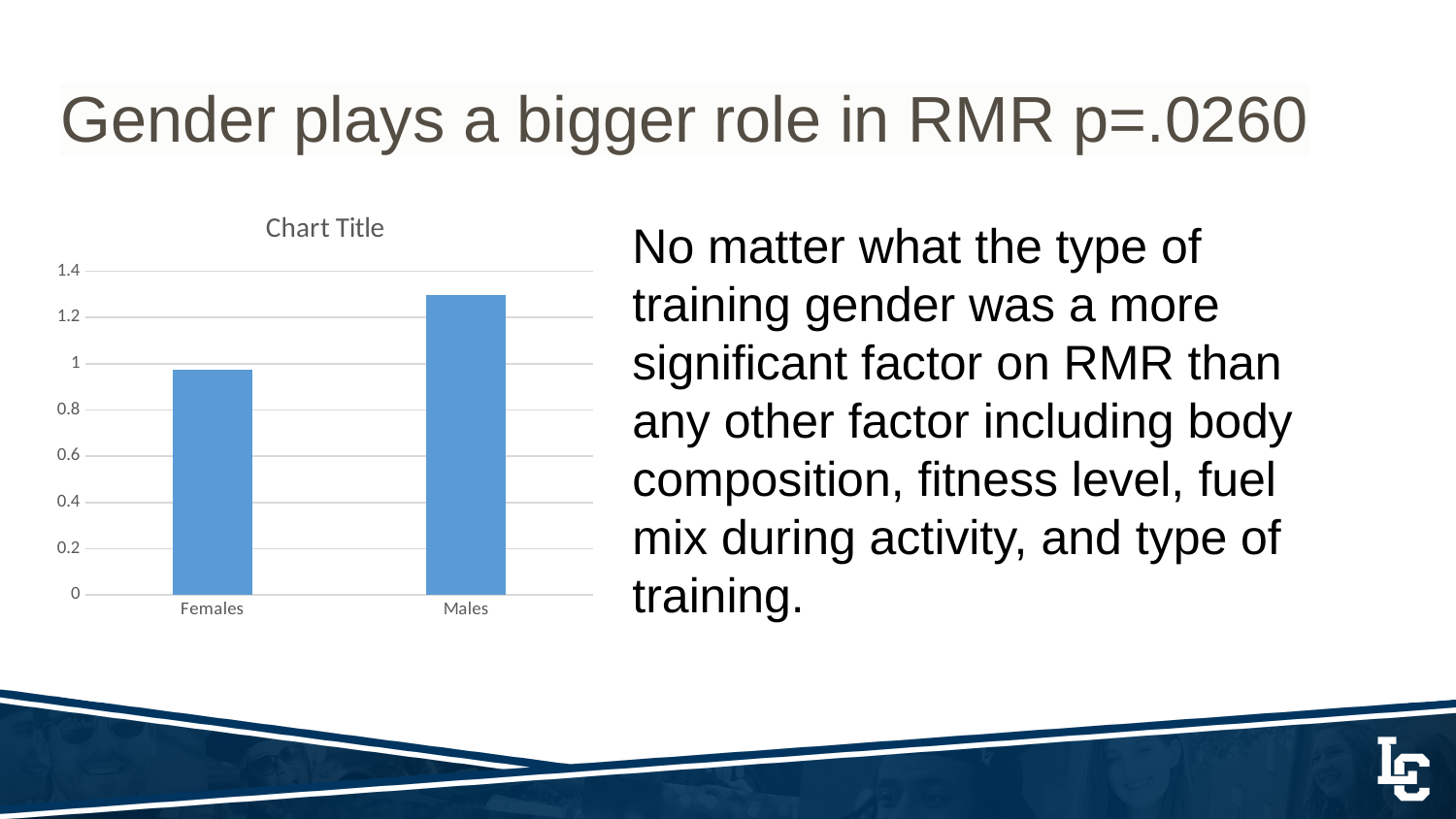
What type of chart is shown on the slide? bar chart Which is larger, the value for Females or the value for Males? Males What is the title shown above the chart? Chart Title Is the value for Females greater or less than 1? less What is the highest value shown on the vertical axis of the chart? 1.4 Is the value for Males greater or less than 1.4? less Which category has the lowest value in the chart? Females Is the value for Females greater or less than 0.8? greater How many categories are plotted in the chart? 2 Which category has the highest value in the chart? Males